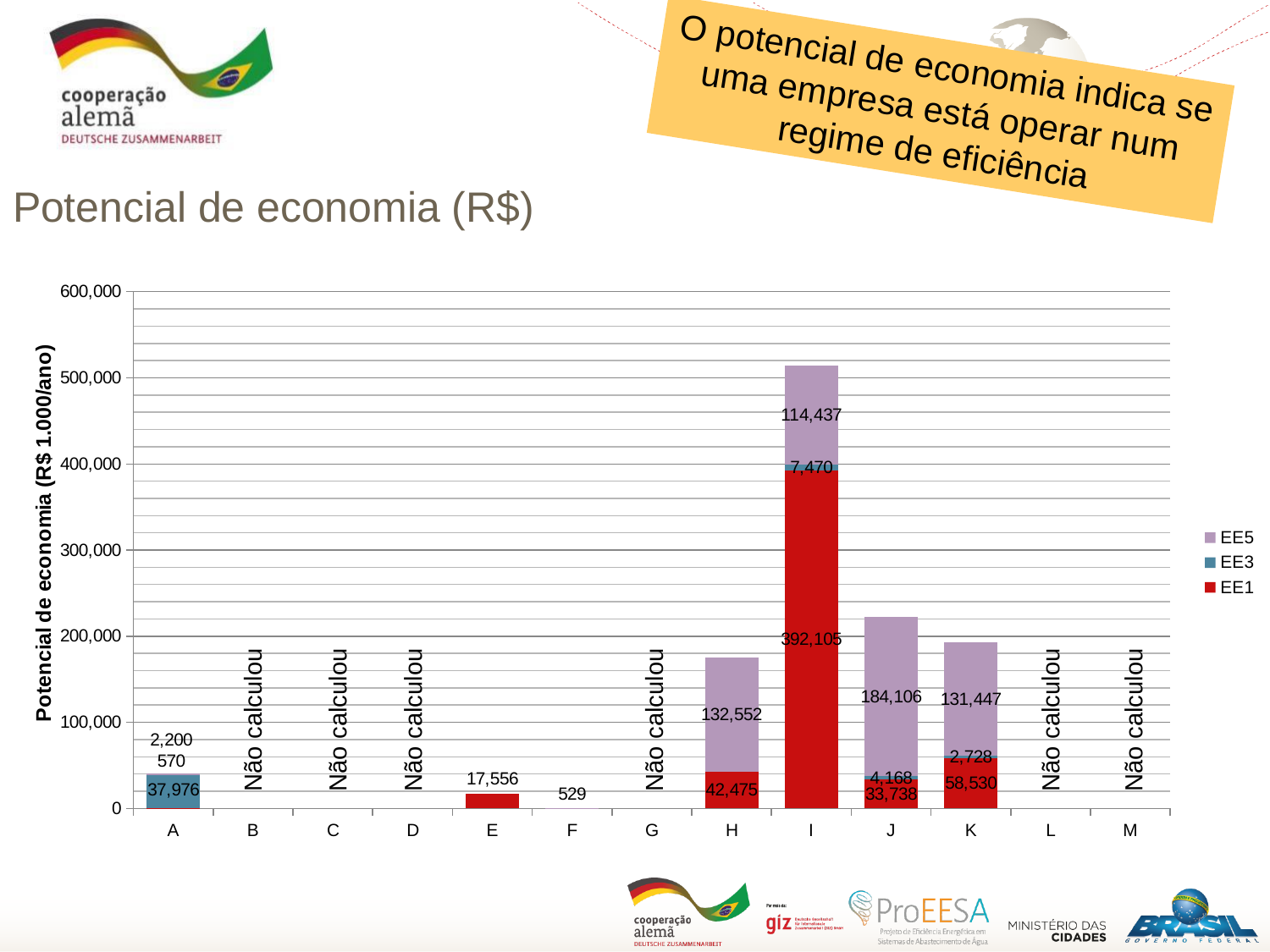
Which is larger, the EE1 value for H or the EE1 value for K? K What is the EE5 value for company H? 132,552 Which company has the tallest bar? I Is the total bar height for company I greater or less than 500,000? greater What kind of chart is shown on the slide? bar chart How many companies are listed on the x axis? 13 What is the EE1 value for company I? 392,105 What is the value shown for company E? 17,556 What is the difference between the EE5 value for J and the EE5 value for K? 52,659 How many companies are marked 'Não calculou'? 6 What is the total of the stacked bar for company I? 514,012 How many series does the legend list? 3